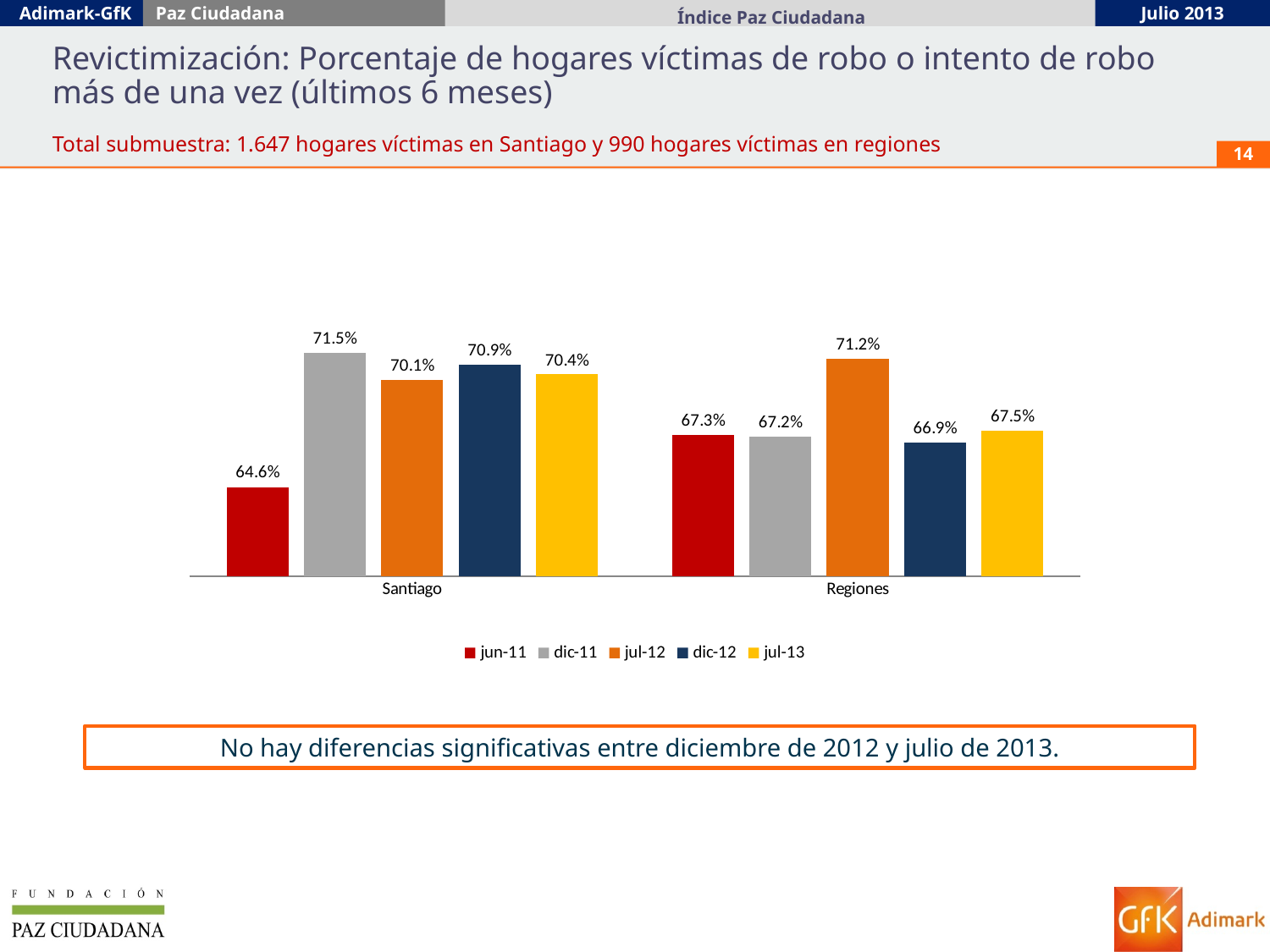
How many series does the legend list? 5 What is the value for jun-11 in Regiones? 67.3% What kind of chart is shown on the slide? Bar chart What is the value for dic-12 in Regiones? 66.9% Which series has the highest value in Regiones? jul-12 What is the difference between the jul-12 and dic-12 values in Regiones? 4.3% What is the difference between the dic-11 and jun-11 values in Santiago? 6.9% What is the value for jul-13 in Santiago? 70.4% Which is larger, the jul-13 value for Santiago or the jul-13 value for Regiones? Santiago How many categories are shown on the x axis? 2 Which series has the lowest value in Santiago? jun-11 Which series has the highest value in Santiago? dic-11